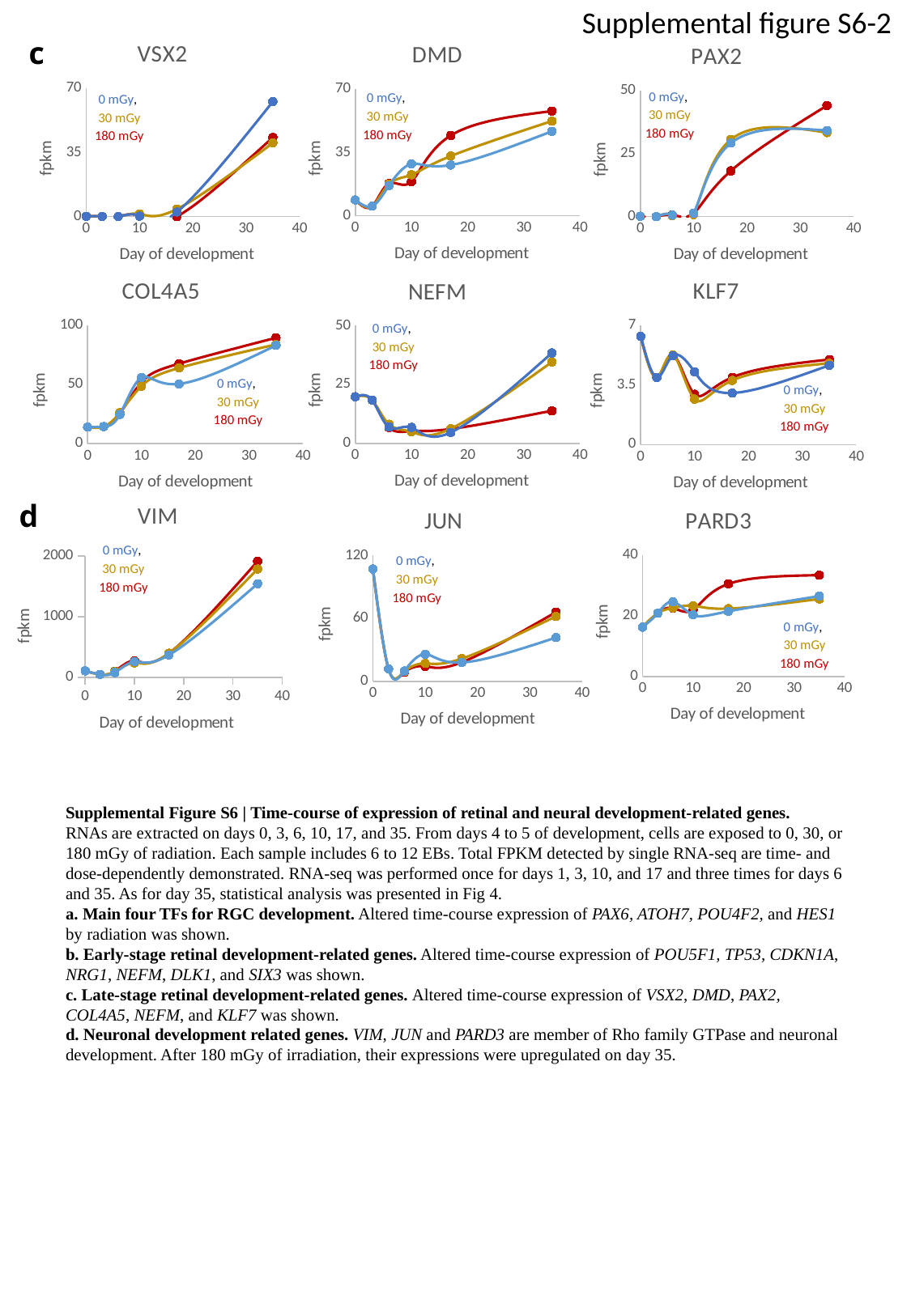
How many series does the legend of the VSX2 chart list? 3 In the NEFM chart, which series has the lowest value at day 35? 180 mGy What is the highest tick shown on the y axis of the KLF7 chart? 7 What kind of chart is the VSX2 chart? line chart In the JUN chart, is the value at day 0 greater or less than 60? greater In the COL4A5 chart, does the 180 mGy series rise or fall from day 0 to day 35? rise What is the x-axis label of the DMD chart? Day of development In the PAX2 chart, which series has the highest value at day 35? 180 mGy In the VIM chart, is the 180 mGy value at day 35 greater or less than 1000? greater In the PARD3 chart, which series has the highest value at day 35? 180 mGy In the VSX2 chart, is the 0 mGy value at day 35 greater or less than 35? greater In the VSX2 chart, which series has the highest value at day 35? 0 mGy